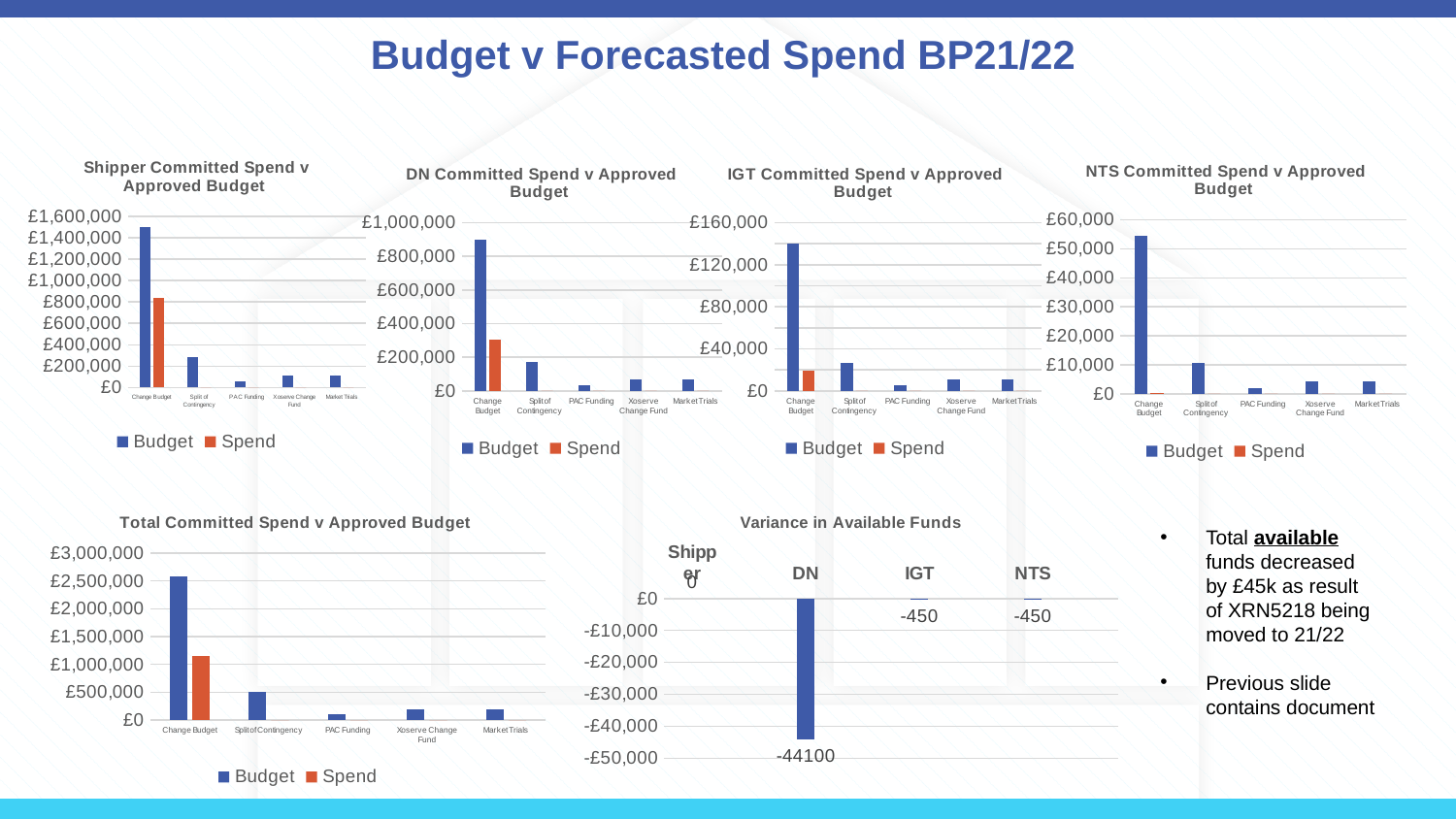
In the 'Variance in Available Funds' chart, what is the value for Shipper? 0 How many categories are shown in the 'Variance in Available Funds' chart? 4 In the 'DN Committed Spend v Approved Budget' chart, is the Budget value for Change Budget greater or less than £800,000? greater In the 'NTS Committed Spend v Approved Budget' chart, is the Budget value for Change Budget greater or less than £50,000? greater In the 'Total Committed Spend v Approved Budget' chart, which category has the highest Budget value? Change Budget In the 'Variance in Available Funds' chart, what is the value for DN? -44100 In the 'Variance in Available Funds' chart, what is the value for IGT? -450 In the 'Shipper Committed Spend v Approved Budget' chart, is the Budget value for Change Budget greater or less than £1,400,000? greater What kind of chart is the 'Variance in Available Funds' chart? bar chart In the 'Shipper Committed Spend v Approved Budget' chart, which is larger for Change Budget: Budget or Spend? Budget In the 'Variance in Available Funds' chart, which category has the lowest value? DN How many series does the legend list in the 'Total Committed Spend v Approved Budget' chart? 2